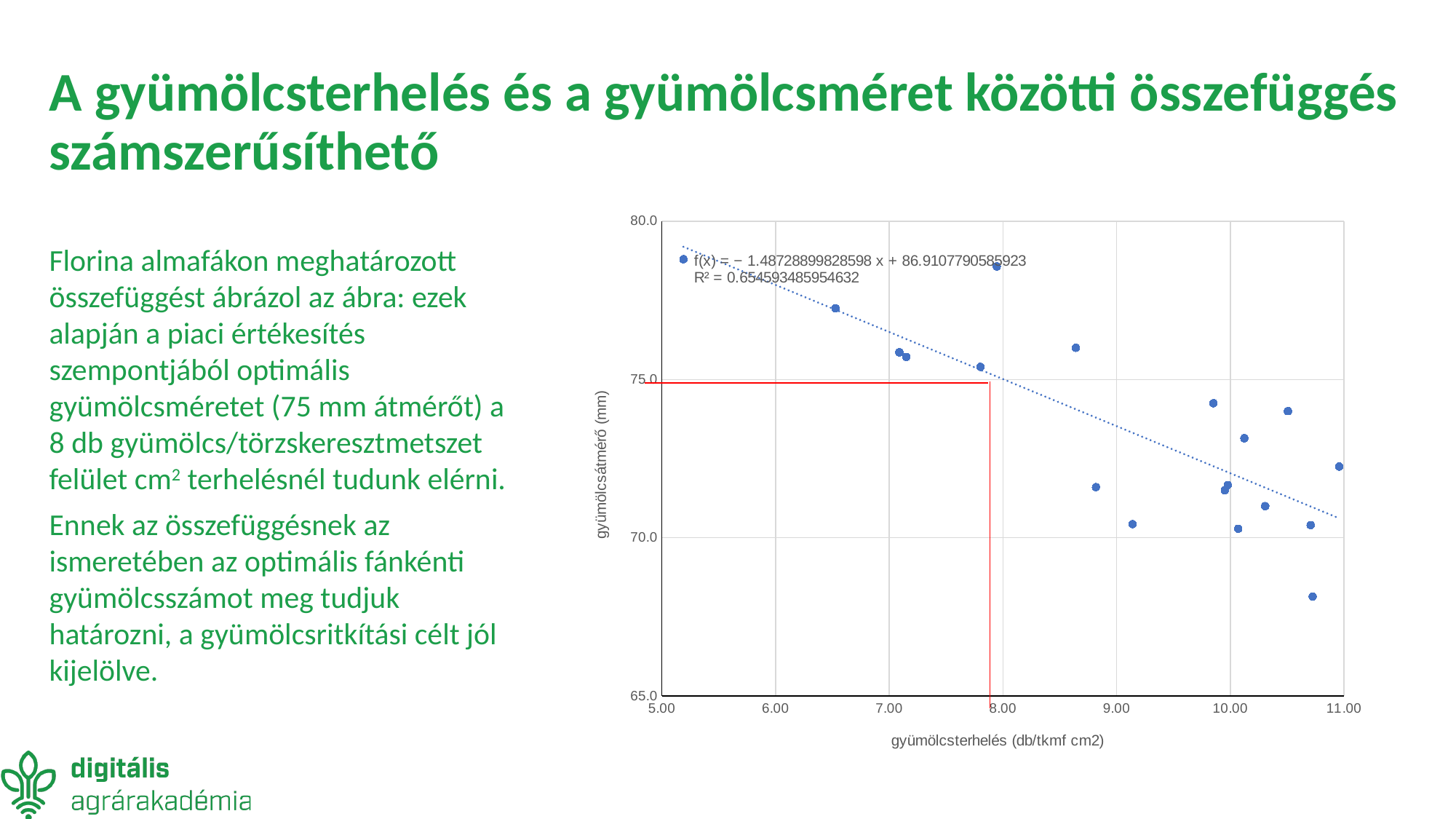
Do the plotted values of gyümölcsátmérő generally rise or fall as gyümölcsterhelés increases along the x axis? fall What kind of chart is shown on the slide? scatter chart What is the R² value printed on the chart? 0.654593485954632 Which point has the larger gyümölcsátmérő: the one at about 6.5 on the x axis or the one at about 9.15? the one at about 6.5 What is the fitted equation f(x) printed on the chart? f(x) = − 1.48728899828598 x + 86.9107790585923 Is the gyümölcsátmérő value for the point at about 8.65 on the x axis greater or less than 75.0? greater What is the label of the x axis? gyümölcsterhelés (db/tkmf cm2) What is the label of the y axis? gyümölcsátmérő (mm) Is the gyümölcsátmérő value for the lowest point near 10.7 on the x axis greater or less than 70.0? less Is the gyümölcsátmérő value for the point at about 5.2 on the x axis greater or less than 75.0? greater